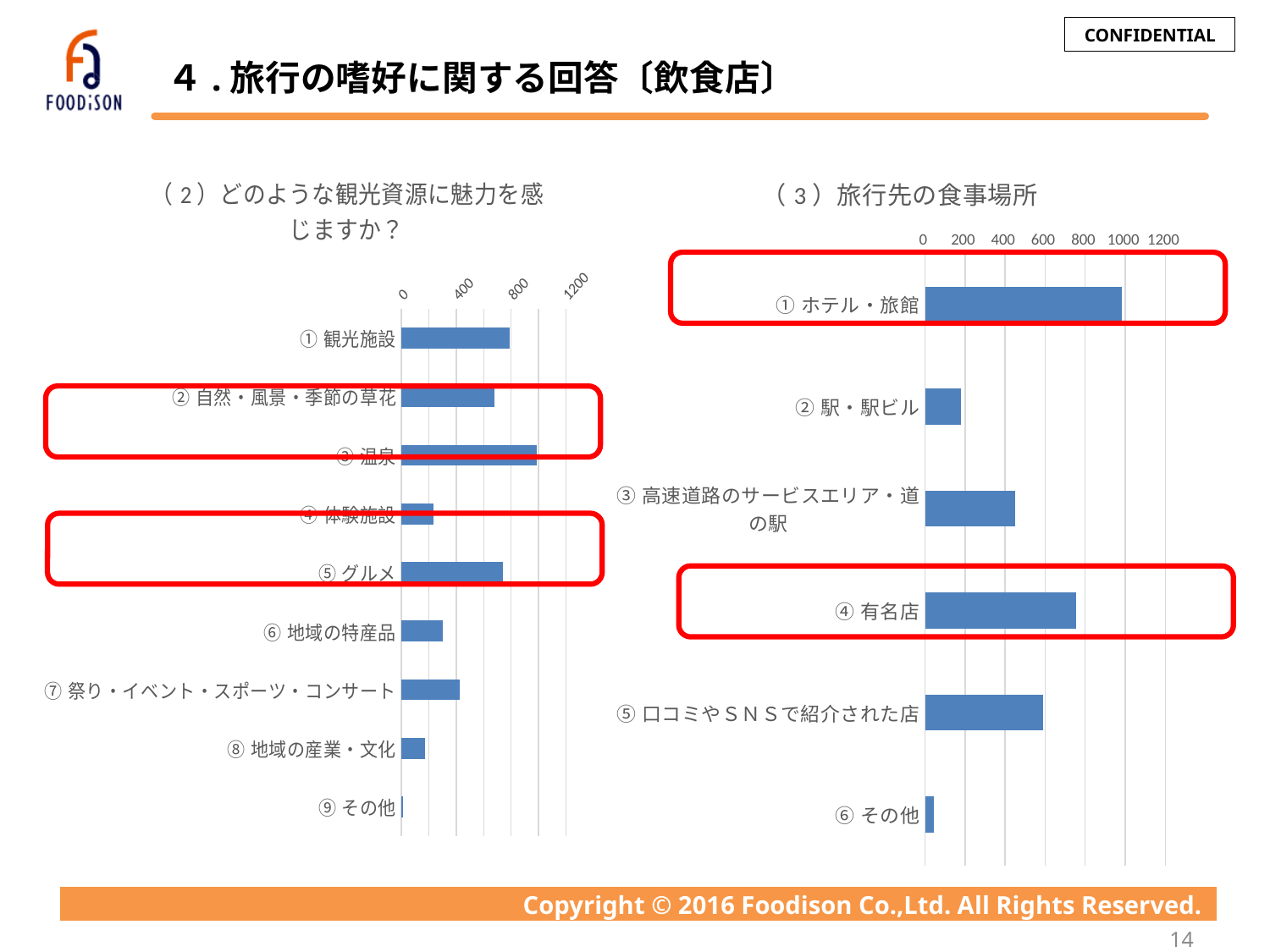
On the chart titled （2）どのような観光資源に魅力を感じますか？, which category has the highest value? ③ 温泉 How many categories are shown on the chart titled （2）どのような観光資源に魅力を感じますか？? 9 On the chart titled （3）旅行先の食事場所, which category has the highest value? ① ホテル・旅館 On the chart titled （3）旅行先の食事場所, is the value for ④ 有名店 greater or less than 600? greater What kind of chart is the chart titled （3）旅行先の食事場所? bar chart On the chart titled （2）どのような観光資源に魅力を感じますか？, is the value for ④ 体験施設 greater or less than 400? less On the chart titled （2）どのような観光資源に魅力を感じますか？, which category has the lowest value? ⑨ その他 On the chart titled （3）旅行先の食事場所, is the value for ② 駅・駅ビル greater or less than 400? less On the chart titled （3）旅行先の食事場所, which category has the lowest value? ⑥ その他 On the chart titled （3）旅行先の食事場所, which is larger: ③ 高速道路のサービスエリア・道の駅 or ② 駅・駅ビル? ③ 高速道路のサービスエリア・道の駅 On the chart titled （2）どのような観光資源に魅力を感じますか？, which is larger: ① 観光施設 or ⑧ 地域の産業・文化? ① 観光施設